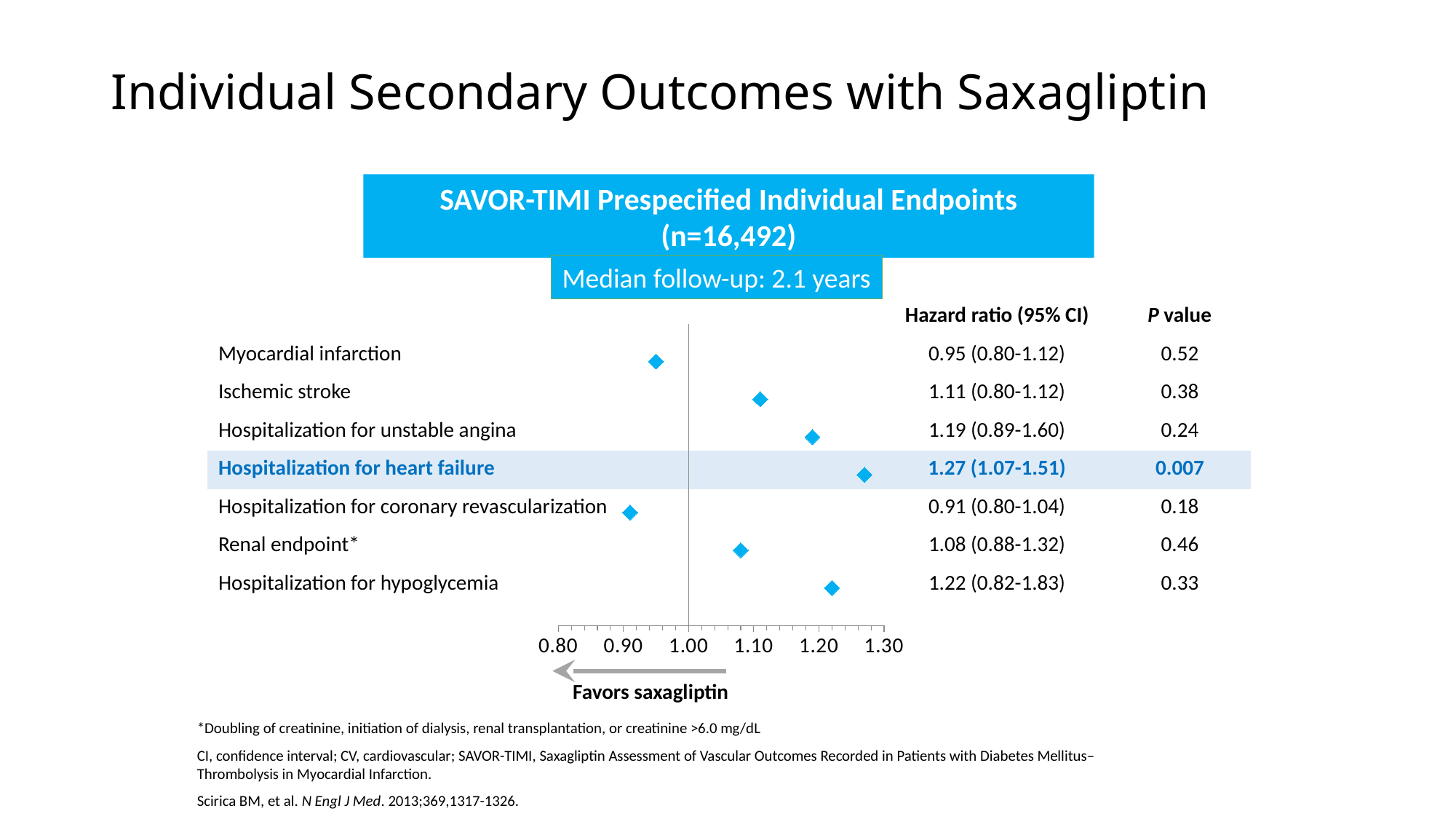
Which endpoint has the lowest hazard ratio? Hospitalization for coronary revascularization What is the P value for myocardial infarction? 0.52 What is the P value for hospitalization for heart failure? 0.007 What kind of chart is shown on the slide? Forest plot What is the hazard ratio (95% CI) for hospitalization for heart failure? 1.27 (1.07-1.51) Which endpoint has the highest hazard ratio? Hospitalization for heart failure What is the difference between the hazard ratios for hospitalization for heart failure and hospitalization for coronary revascularization? 0.36 How many endpoints are plotted in the chart? 7 What is the hazard ratio for the renal endpoint? 1.08 Which has the larger hazard ratio, ischemic stroke or myocardial infarction? Ischemic stroke Is the hazard ratio for myocardial infarction greater or less than 1.00? less What is the median follow-up stated on the chart? 2.1 years